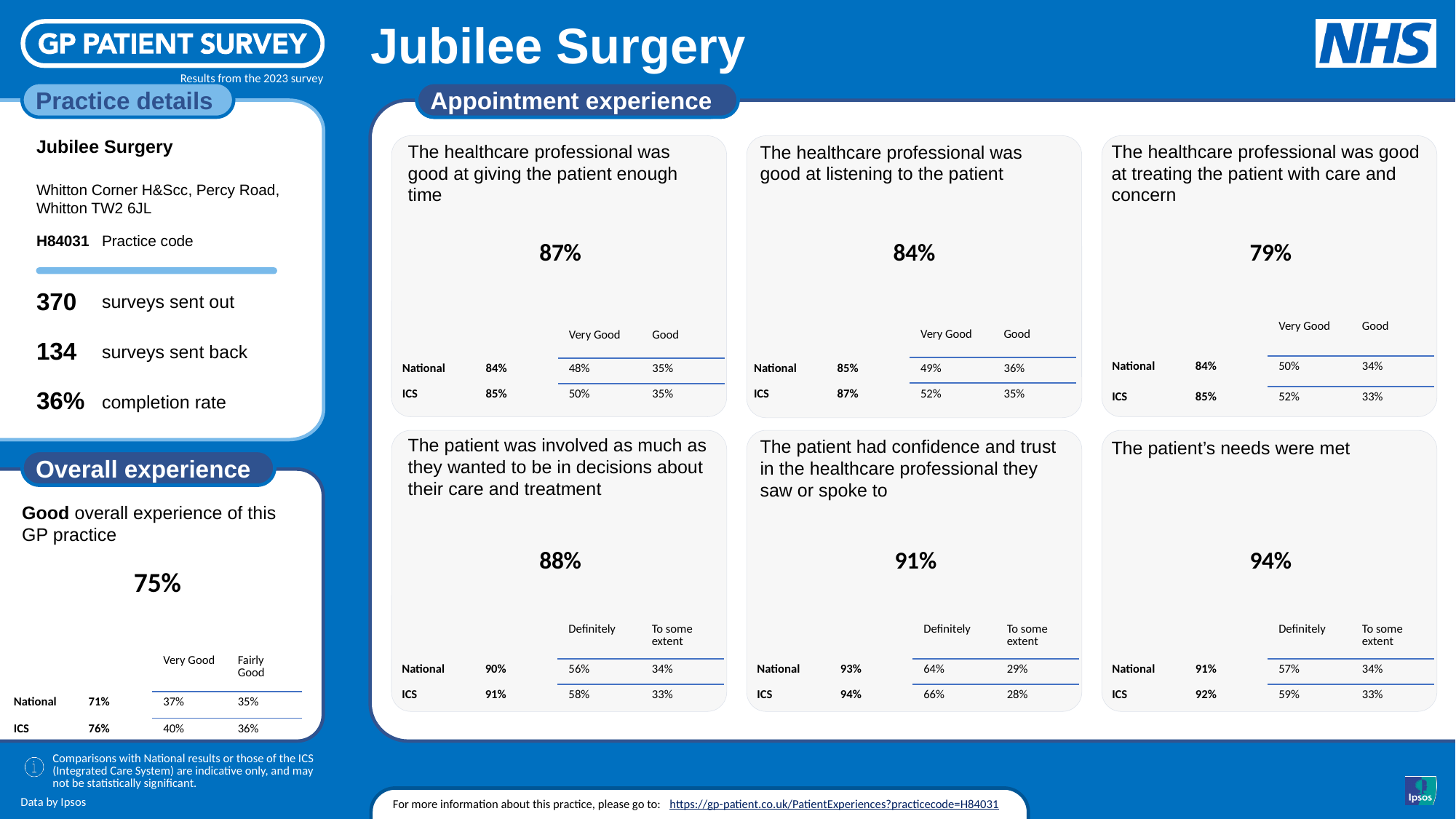
In the 'The healthcare professional was good at treating the patient with care and concern' panel, what is the ICS 'Very Good' percentage? 52% In the 'Overall experience' panel, what is the practice's percentage for Good overall experience of this GP practice? 75% In the 'The patient had confidence and trust in the healthcare professional they saw or spoke to' panel, what is the difference between the ICS value and the National value? 1% Across the six Appointment experience panels, which question has the highest practice headline percentage? The patient's needs were met In the 'The healthcare professional was good at listening to the patient' panel, what is the National value? 85% In the 'The patient's needs were met' panel, what is the practice's headline percentage? 94% How many question panels are shown under the 'Appointment experience' heading? 6 Across the six Appointment experience panels, which question has the lowest practice headline percentage? The healthcare professional was good at treating the patient with care and concern In the 'Overall experience' panel, what is the difference between the ICS value and the National value? 5% In the 'The patient was involved as much as they wanted to be in decisions about their care and treatment' panel, which is larger: the National 'Definitely' percentage or the ICS 'Definitely' percentage? ICS In the 'The healthcare professional was good at giving the patient enough time' panel, what is the practice's headline percentage? 87% In the 'Overall experience' panel, what is the National 'Fairly Good' percentage? 35%